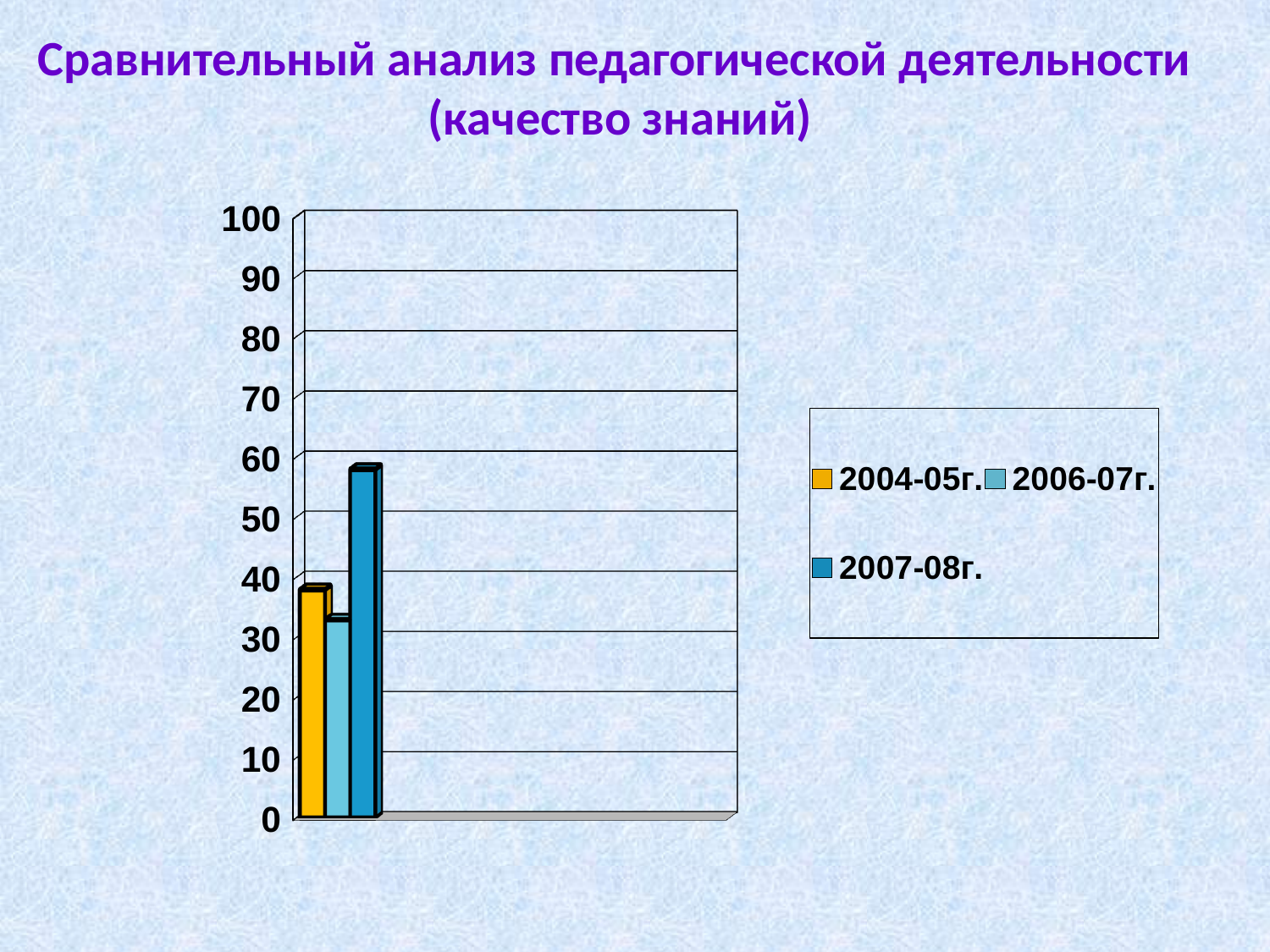
How many series does the legend list? 3 Which series has the lowest bar? 2006-07г. Which series has the highest bar? 2007-08г. Which is larger, the value for 2004-05г. or the value for 2007-08г.? 2007-08г. What is the maximum value shown on the vertical axis? 100 Is the value for 2007-08г. greater or less than 60? less Is the value for 2006-07г. greater or less than 30? greater Is the value for 2007-08г. greater or less than 50? greater Which is larger, the value for 2004-05г. or the value for 2006-07г.? 2004-05г. Which series is shown in yellow in the legend? 2004-05г. What kind of chart is shown on the slide? bar chart